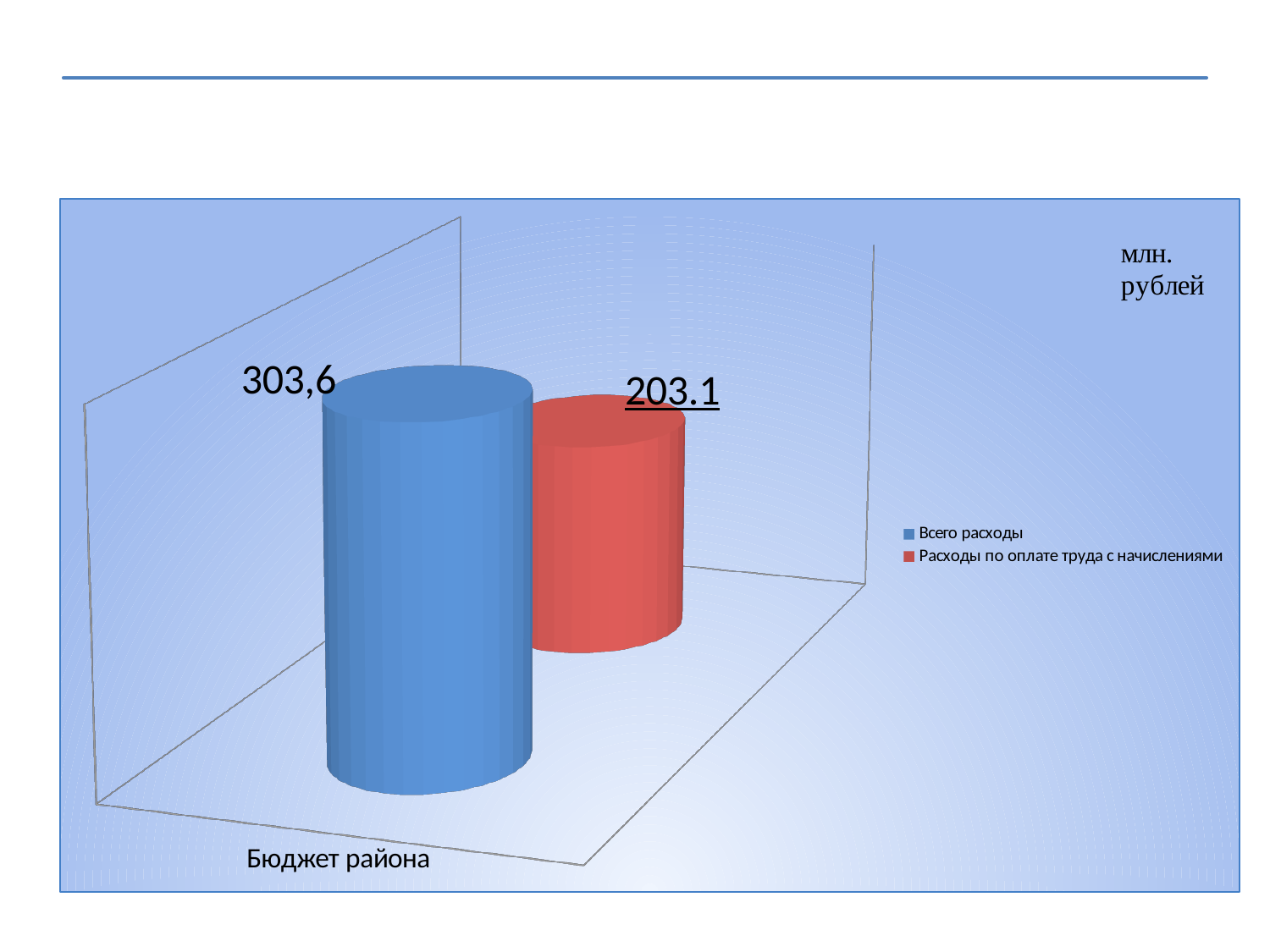
Is the value for Всего расходы larger or smaller than the value for Расходы по оплате труда с начислениями? larger What unit is indicated in the top right corner of the chart? млн. рублей What kind of chart is shown on the slide? bar chart Which series has the lower value in the chart? Расходы по оплате труда с начислениями Which series has the higher value in the chart? Всего расходы How many series does the legend list? 2 What is the value for Расходы по оплате труда с начислениями in the chart? 203.1 How many categories are shown on the x axis of the chart? 1 What is the difference between Всего расходы and Расходы по оплате труда с начислениями? 100,5 What is the name of the category shown on the x axis? Бюджет района What is the value for Всего расходы in the chart? 303,6